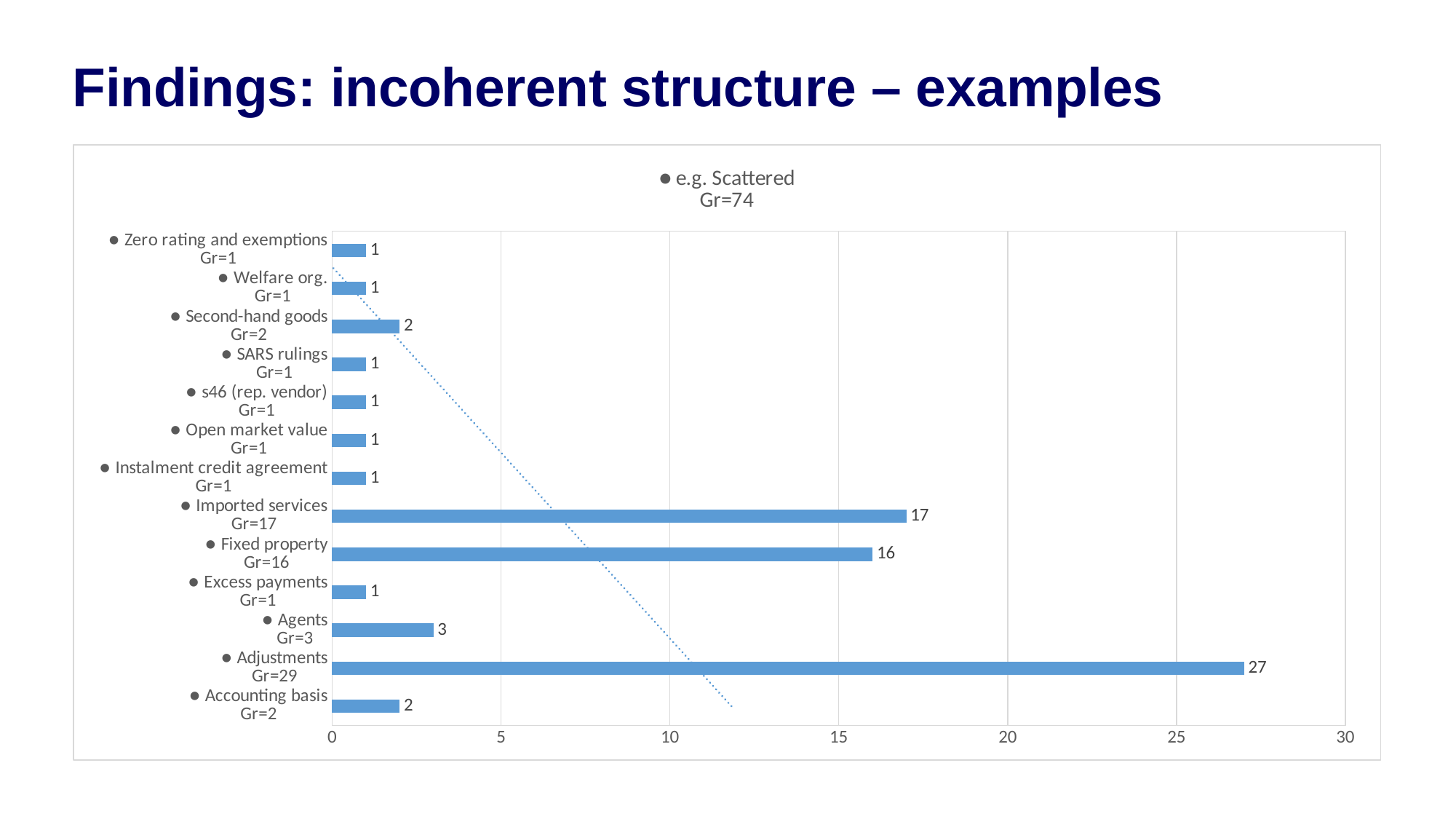
Which is larger, the value for Agents or the value for Second-hand goods? Agents What is the value for Adjustments? 27 Is the value for Adjustments greater or less than 25? greater What kind of chart is shown on the slide? bar chart How many categories are plotted in the chart? 13 What is the title of the chart? e.g. Scattered Gr=74 What is the value for Fixed property? 16 What is the difference between the values for Imported services and Fixed property? 1 What is the value for Imported services? 17 What is the difference between the values for Adjustments and Imported services? 10 Which category has the highest value? Adjustments What is the value for Agents? 3